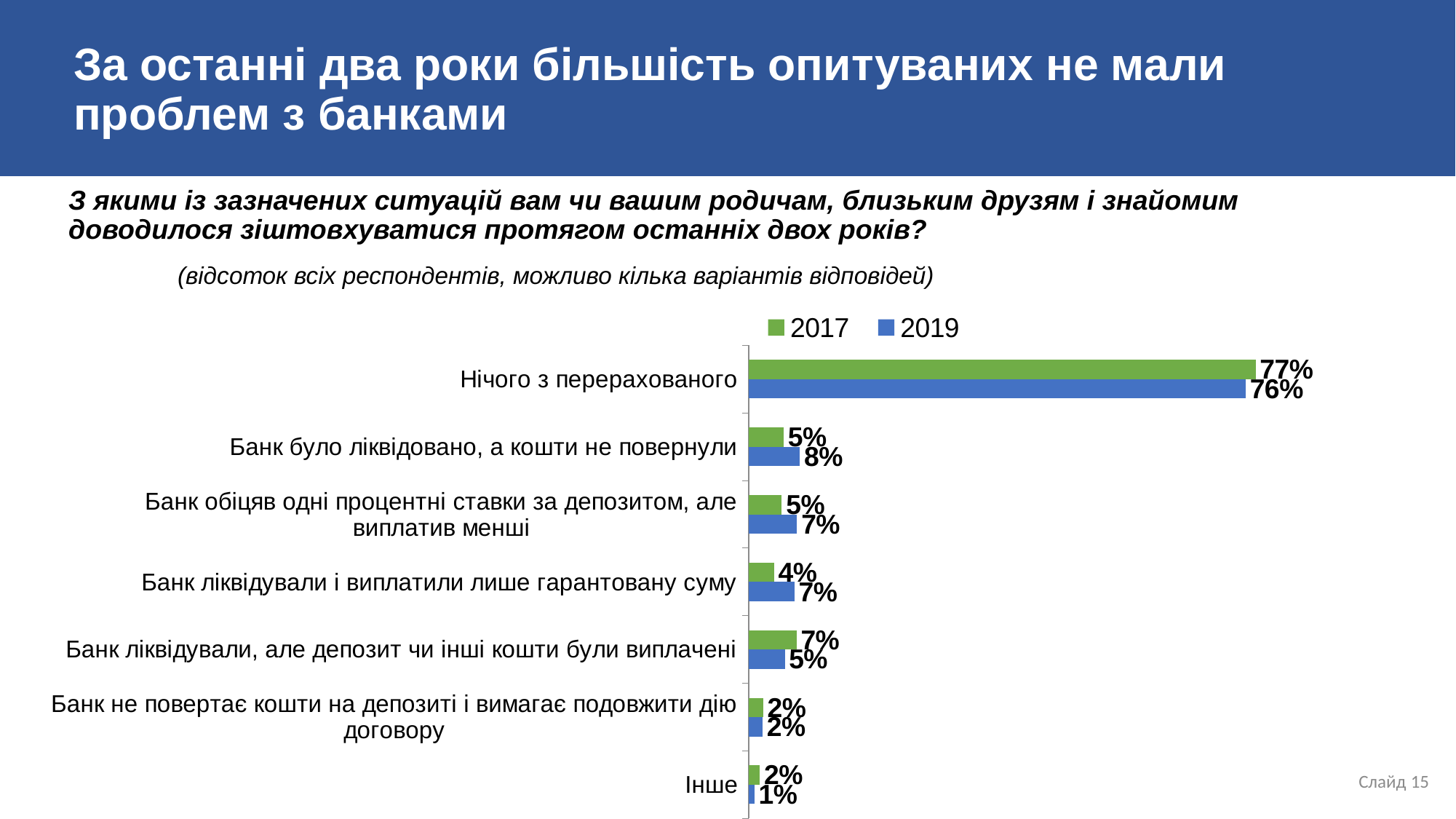
Which category has the lowest 2019 value? Інше Which category has the highest 2019 value? Нічого з перерахованого What is the 2019 value for "Інше"? 1% How many series does the chart legend list? 2 What is the 2017 value for "Банк ліквідували, але депозит чи інші кошти були виплачені"? 7% What is the difference between the 2019 and 2017 values for "Банк ліквідували і виплатили лише гарантовану суму"? 3% What is the 2019 value for "Нічого з перерахованого"? 76% For "Банк ліквідували, але депозит чи інші кошти були виплачені", which year has the larger value, 2017 or 2019? 2017 What is the 2019 value for "Банк було ліквідовано, а кошти не повернули"? 8% How many categories are shown in the chart? 7 What is the 2017 value for "Нічого з перерахованого"? 77% What type of chart is shown on the slide? bar chart